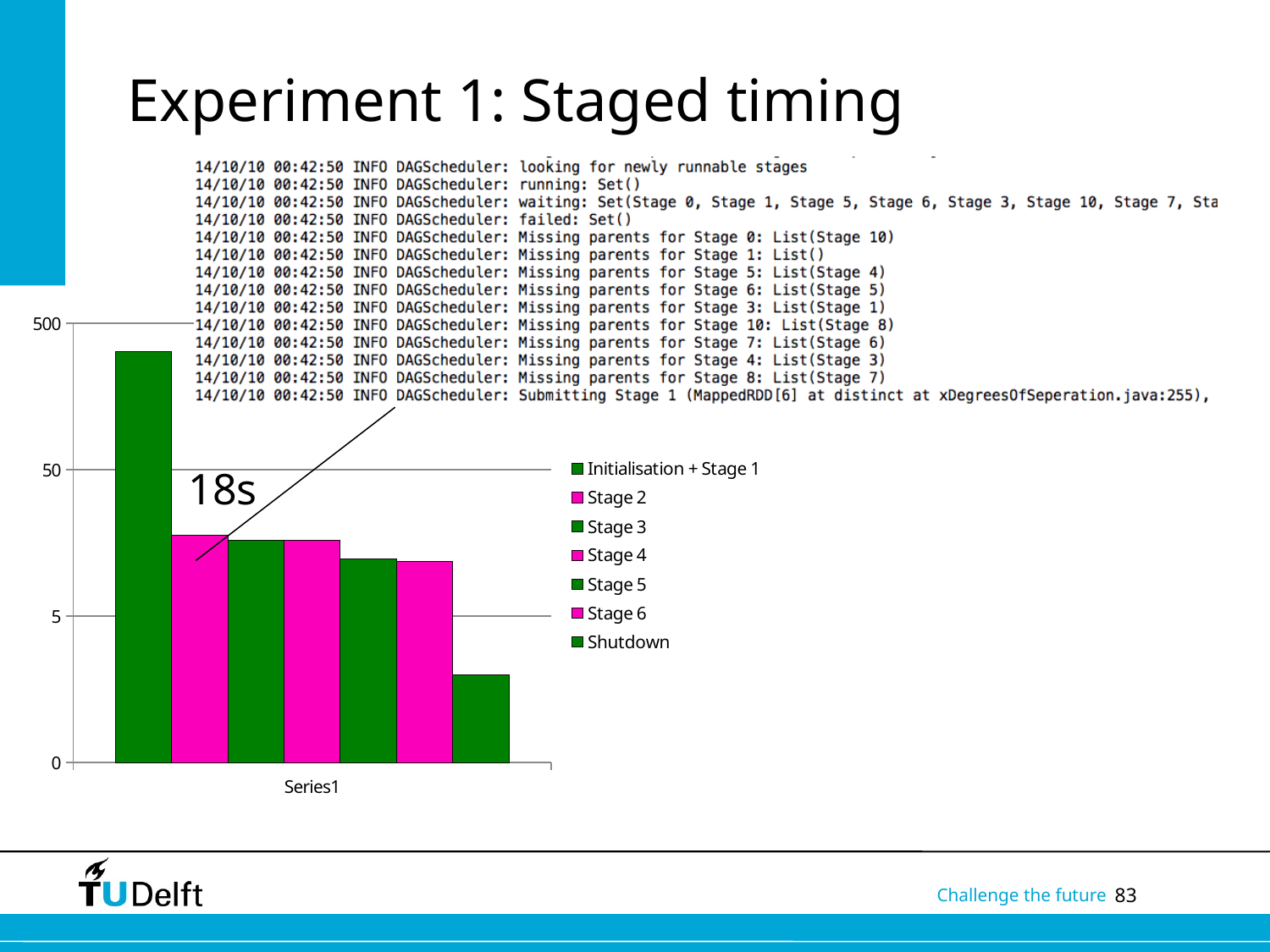
Is the value for Initialisation + Stage 1 greater or less than 50? greater What value is annotated for the Stage 2 bar? 18s Which series has the tallest bar in the chart? Initialisation + Stage 1 What label appears on the x axis beneath the bars? Series1 Which is larger, the bar for Stage 6 or the bar for Shutdown? Stage 6 Is the value for Shutdown greater or less than 5? less Is the value for Stage 3 greater or less than 5? greater Which series has the shortest bar in the chart? Shutdown How many series does the chart legend list? 7 Which is larger, the bar for Initialisation + Stage 1 or the bar for Stage 2? Initialisation + Stage 1 How many bars are plotted in the chart? 7 What kind of chart is shown on the slide? bar chart